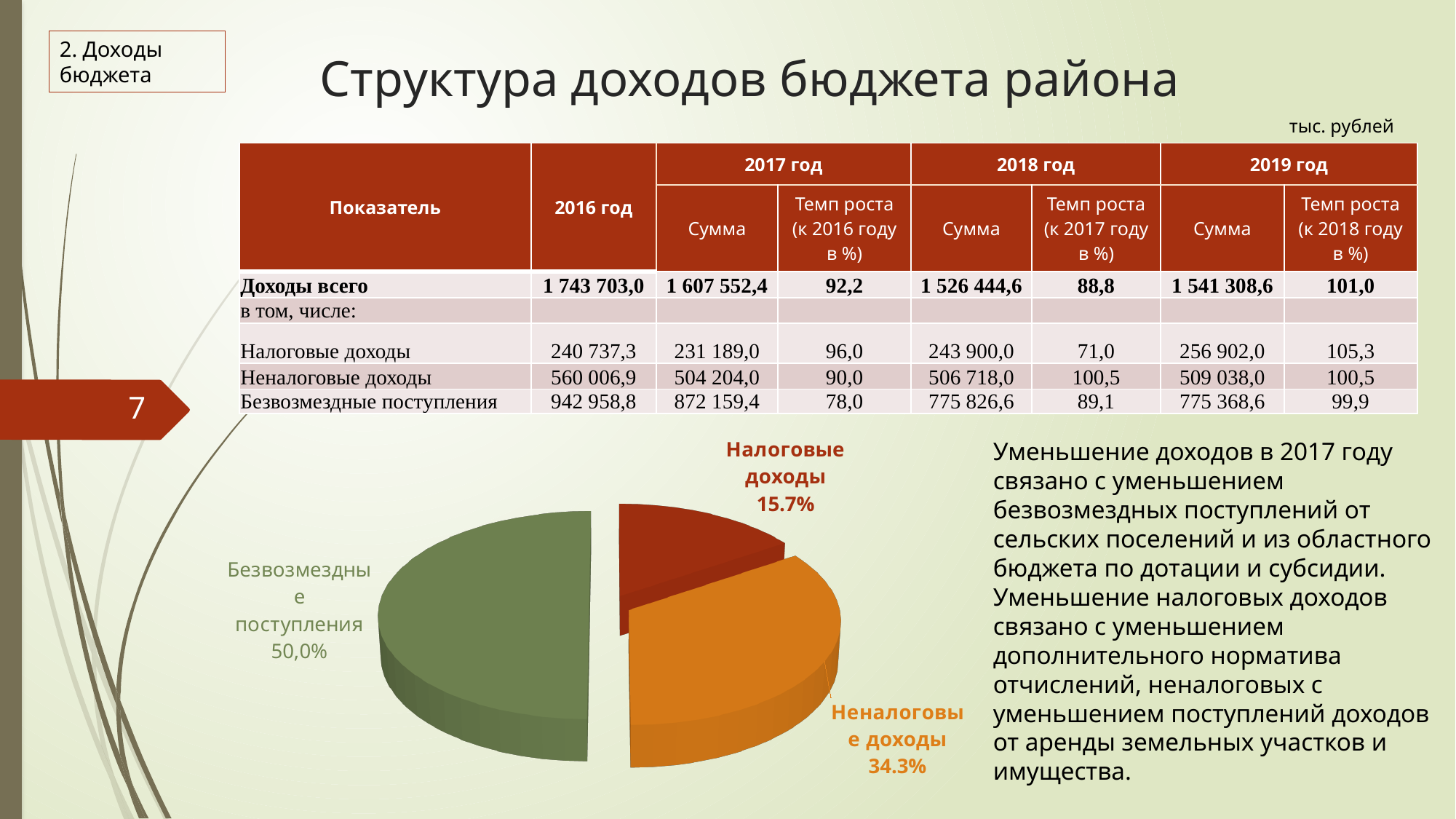
In the pie chart, which is larger: Неналоговые доходы or Налоговые доходы? Неналоговые доходы What colour is the Неналоговые доходы slice in the pie chart? Orange What colour is the Безвозмездные поступления slice in the pie chart? Green How many slices does the pie chart have? 3 In the pie chart, what is the difference in percentage points between Неналоговые доходы and Налоговые доходы? 18.6 What kind of chart is shown on the slide? Pie chart Which slice of the pie chart is the smallest? Налоговые доходы Which slice of the pie chart is the largest? Безвозмездные поступления What share of the pie chart is labelled for Неналоговые доходы? 34.3% What share of the pie chart is labelled for Налоговые доходы? 15.7% What share of the pie chart is labelled for Безвозмездные поступления? 50,0% In the pie chart, what is the difference in percentage points between Безвозмездные поступления and Неналоговые доходы? 15.7